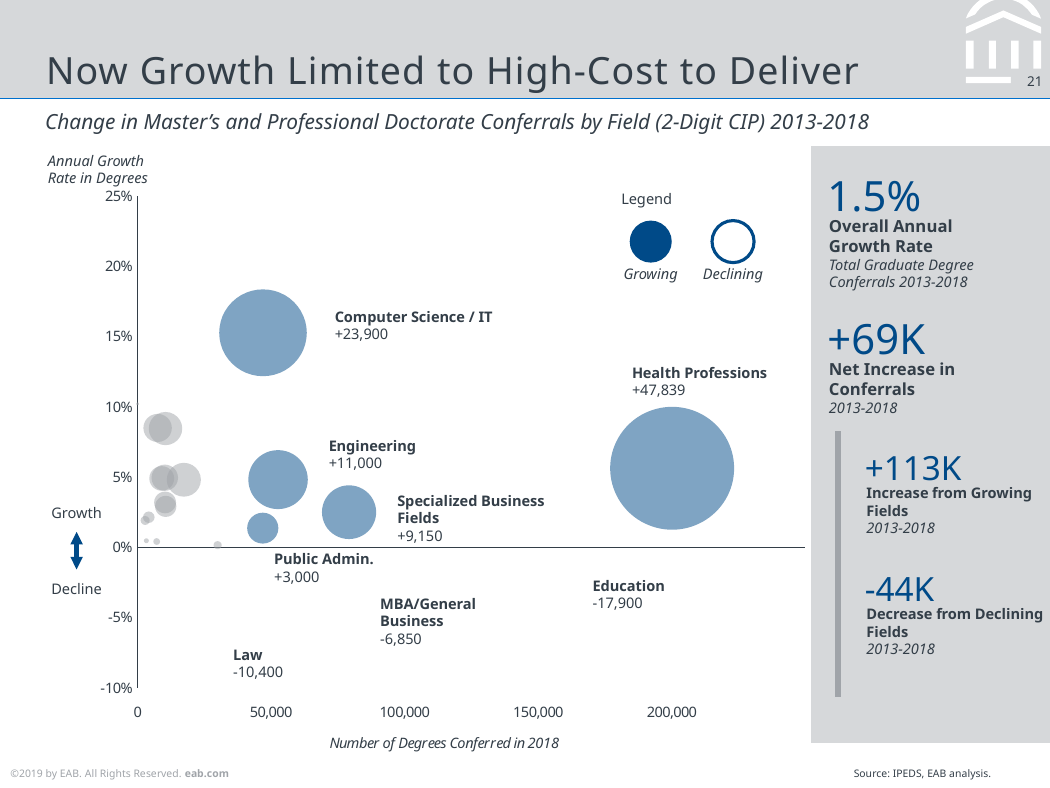
Is the number of degrees conferred in 2018 for Health Professions greater or less than 150,000? greater How much larger is the increase for Health Professions than for Computer Science / IT? 23,939 Which has the larger increase in conferrals, Engineering or Specialized Business Fields? Engineering What is the change in conferrals shown for Health Professions? +47,839 How many entries does the chart legend list? 2 What is the change in conferrals shown for Law? -10,400 What is the change in conferrals shown for Education? -17,900 What is the change in conferrals shown for Computer Science / IT? +23,900 Is the annual growth rate for Computer Science / IT greater or less than 10%? greater Which labeled field has the largest increase in conferrals? Health Professions Which labeled field has the largest decrease in conferrals? Education What kind of chart is shown on the slide? Bubble chart